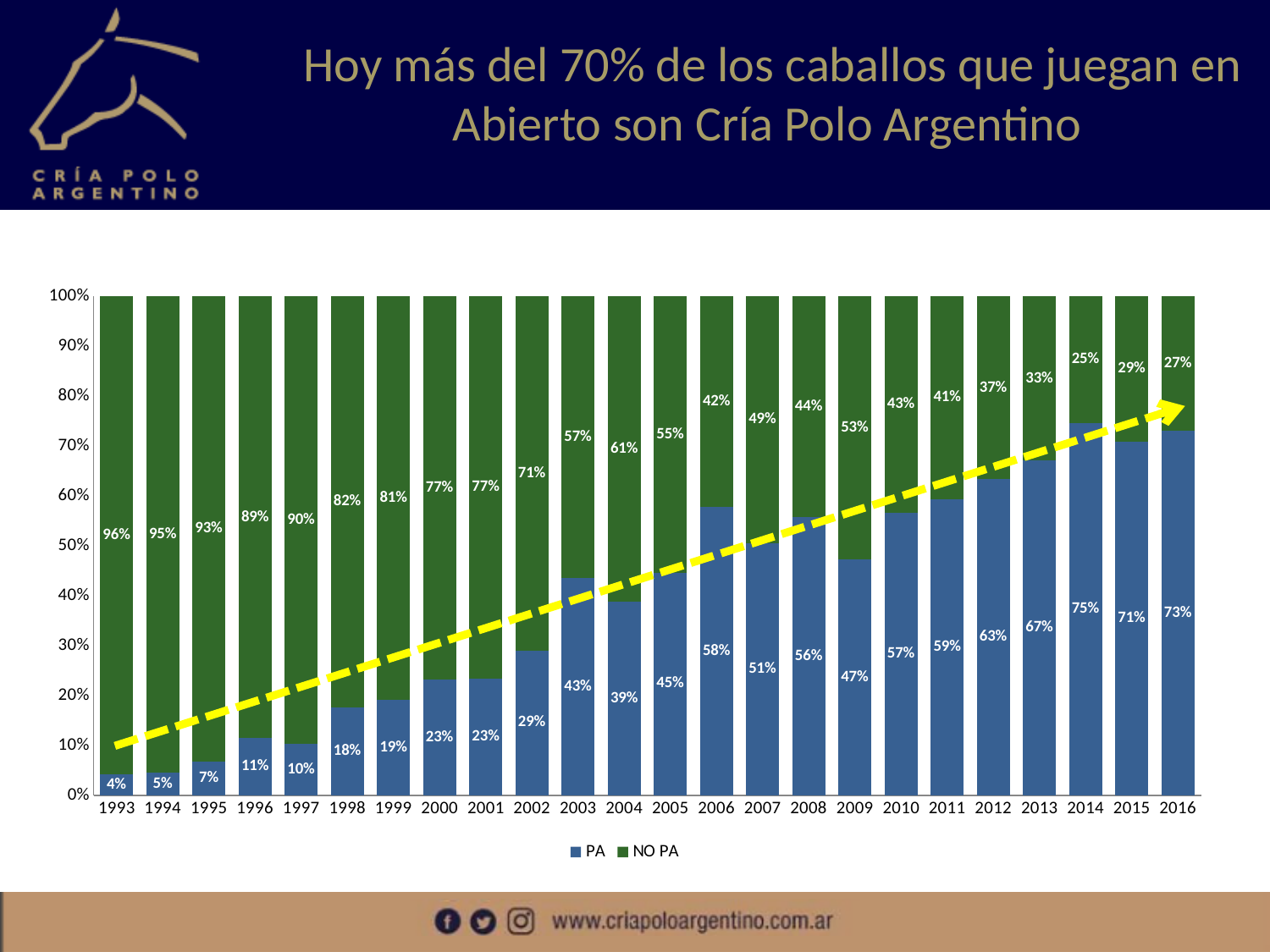
What is the difference between the PA value in 2016 and the PA value in 1993? 69% What is the NO PA value for 1993? 96% In which year is the PA share lowest? 1993 How many series does the legend list? 2 What is the PA value for 2016? 73% Which is larger, the PA value for 2003 or the PA value for 2004? 2003 In which year is the PA share highest? 2014 How many years are shown on the x axis? 24 Does the PA share generally rise or fall from 1993 to 2016? Rise What kind of chart is shown on the slide? Stacked bar chart What is the PA value for 2006? 58% Which series is shown in green? NO PA